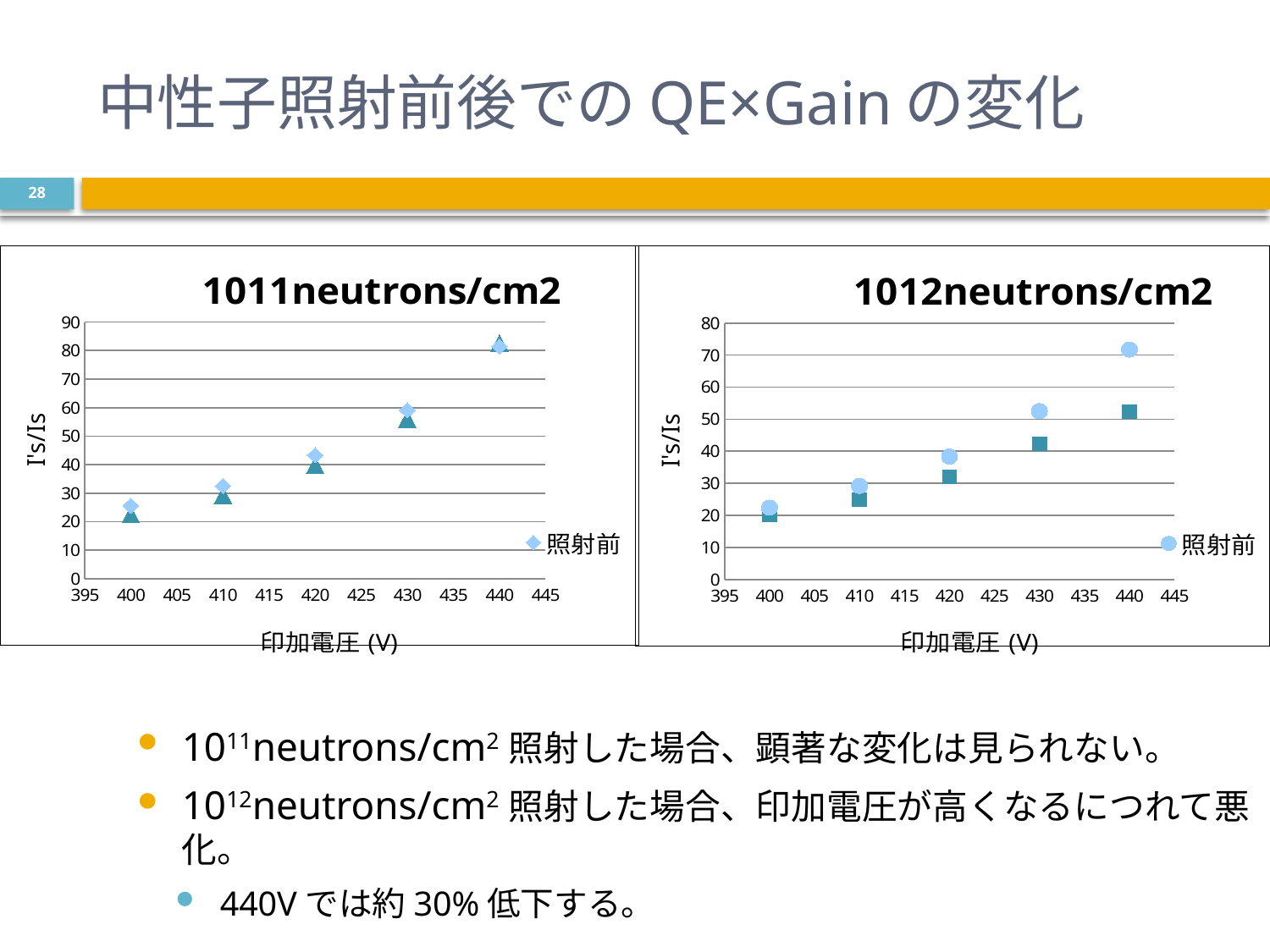
In the chart titled 1011neutrons/cm2, do the values rise or fall as the applied voltage increases? rise In the chart titled 1012neutrons/cm2, is the 照射前 value at 440 V greater or less than 60? greater What is the y-axis label of the chart titled 1011neutrons/cm2? I's/Is In the chart titled 1011neutrons/cm2, is the 照射前 value at 440 V greater or less than 70? greater In the chart titled 1012neutrons/cm2, is the square-marker value at 440 V greater or less than 60? less How many data points does the 照射前 series have in the chart titled 1012neutrons/cm2? 5 In the chart titled 1012neutrons/cm2, at 440 V, which is larger: the 照射前 (circle) value or the square-marker value? 照射前 (circle) What is the x-axis label of the chart titled 1012neutrons/cm2? 印加電圧 (V) In the chart titled 1012neutrons/cm2, do the values rise or fall as the applied voltage increases? rise What kind of chart is the chart titled 1011neutrons/cm2? scatter chart